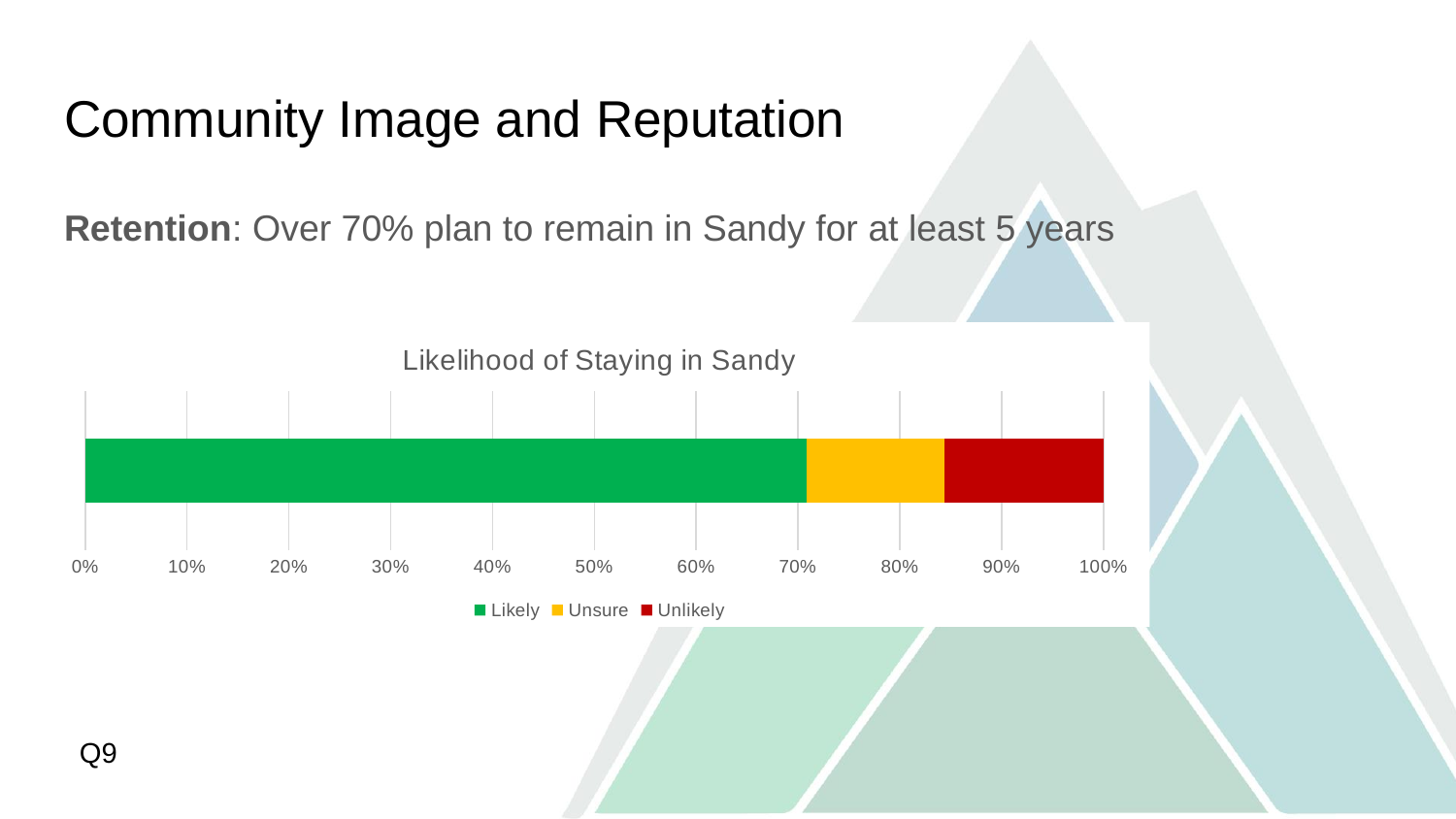
What colour represents the Unlikely series? Red What kind of chart is shown on the slide? Stacked bar chart How many series does the chart legend list? 3 What is the title of the chart? Likelihood of Staying in Sandy Is the value for Unlikely greater or less than 30%? less Is the value for Unsure greater or less than 20%? less Which is larger, the Likely segment or the Unlikely segment? Likely Which series takes up the largest portion of the bar? Likely Is the value for Likely greater or less than 60%? greater How many bars are plotted in the chart? 1 What is the highest value shown on the x axis? 100%